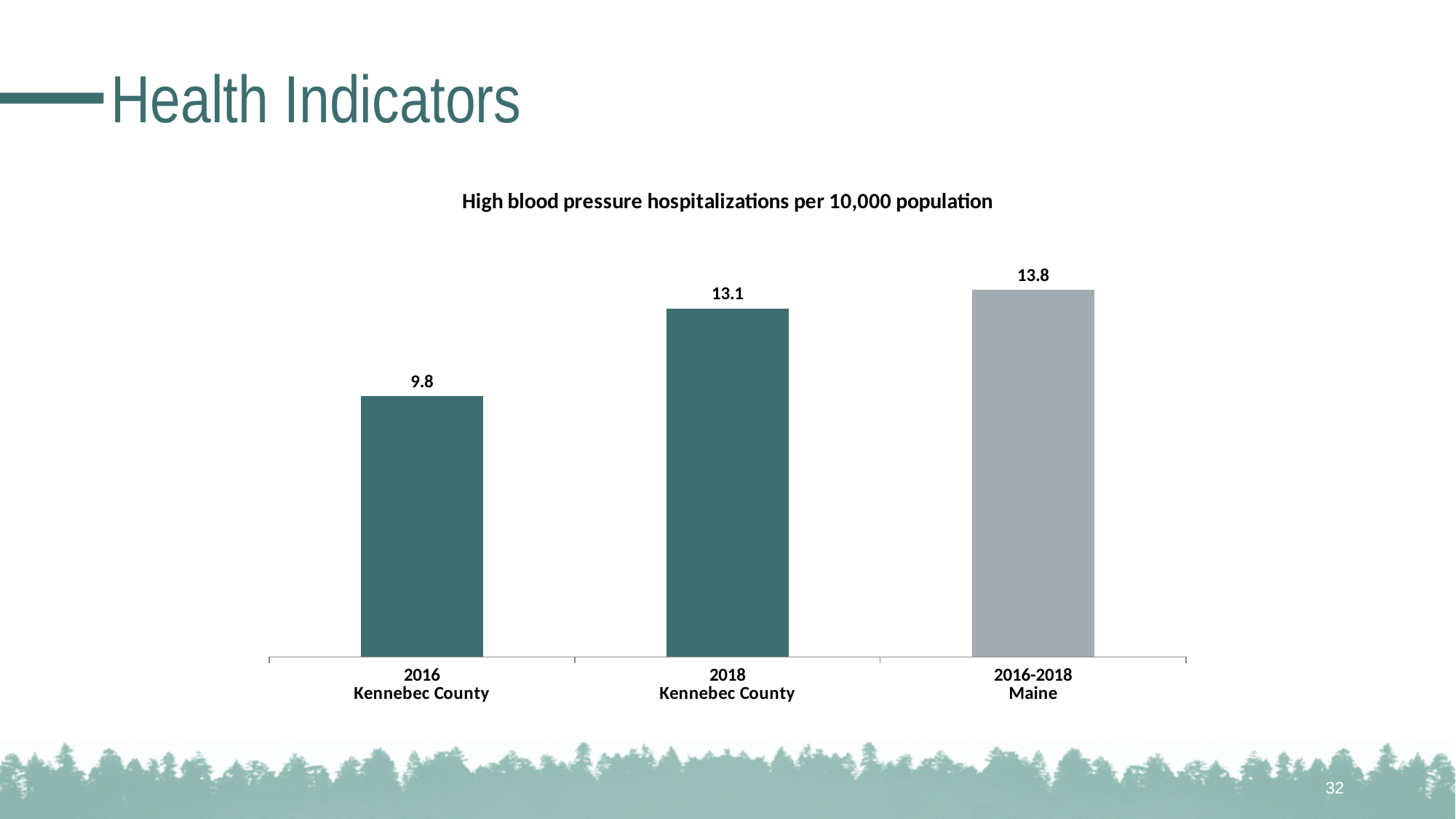
What is the value for 2018 Kennebec County? 13.1 What kind of chart is shown on the slide? Bar chart What is the value for 2016-2018 Maine? 13.8 What is the difference between the 2018 Kennebec County value and the 2016 Kennebec County value? 3.3 Which is larger, the value for 2016 Kennebec County or the value for 2018 Kennebec County? 2018 Kennebec County What is the title of the chart? High blood pressure hospitalizations per 10,000 population Do the values rise or fall from left to right across the chart? Rise Which category has the highest value? 2016-2018 Maine Which category has the lowest value? 2016 Kennebec County What is the difference between the 2016-2018 Maine value and the 2018 Kennebec County value? 0.7 How many bars are shown in the chart? 3 What is the value for 2016 Kennebec County? 9.8